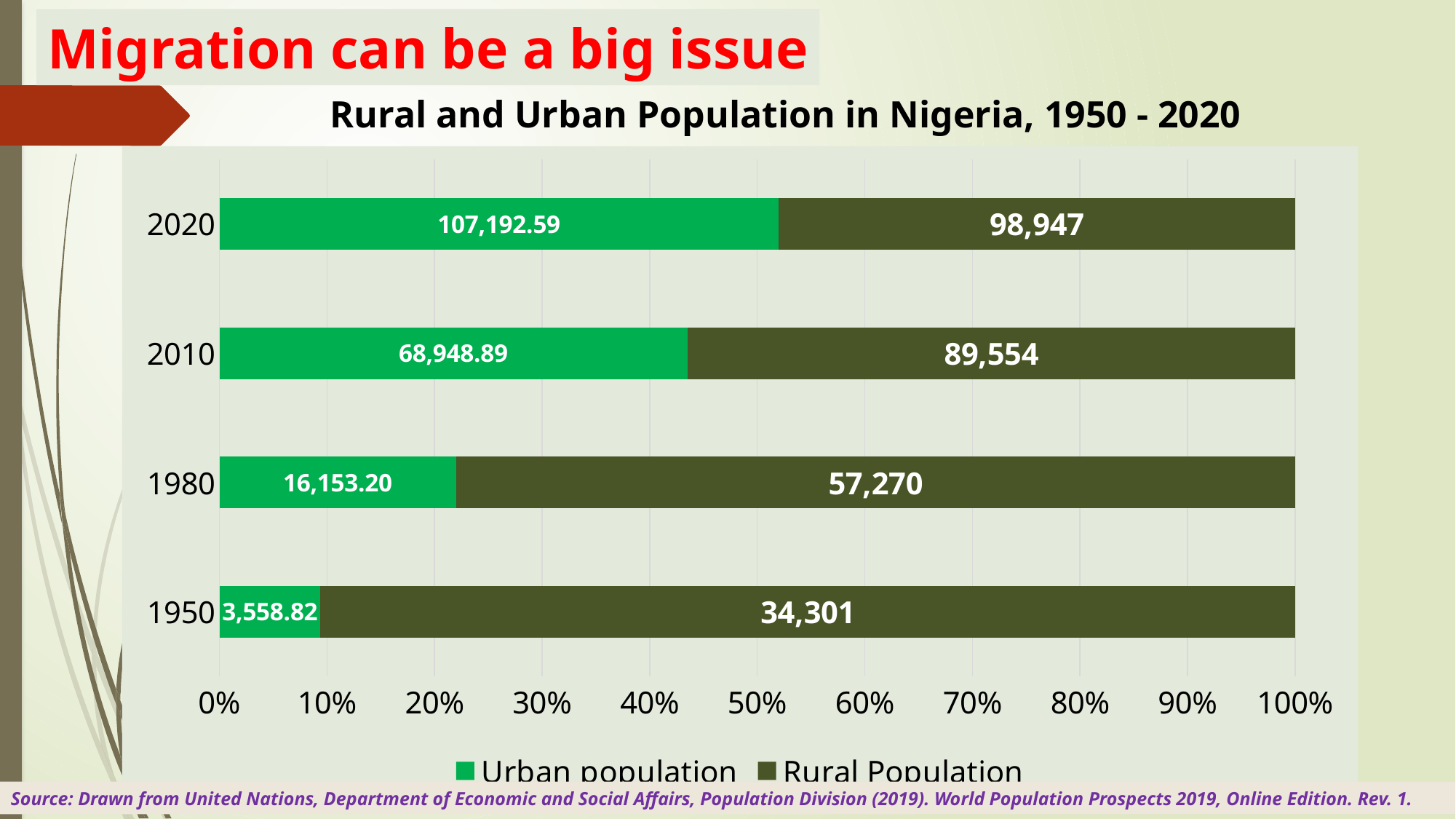
What is the difference between the rural population in 2020 and in 2010? 9,393 Which year has the highest rural population value? 2020 Is the urban population share of the 2010 bar greater or less than 50%? less In 2010, which is larger, the urban population or the rural population? Rural population What is the rural population value shown for 1980? 57,270 What kind of chart is shown on the slide? Stacked bar chart Does the urban population share of the bars rise or fall from 1950 to 2020? Rise What is the urban population value shown for 2020? 107,192.59 Which year has the lowest urban population value? 1950 How many years are shown on the chart? 4 What is the urban population value shown for 1950? 3,558.82 How many series does the legend list? 2